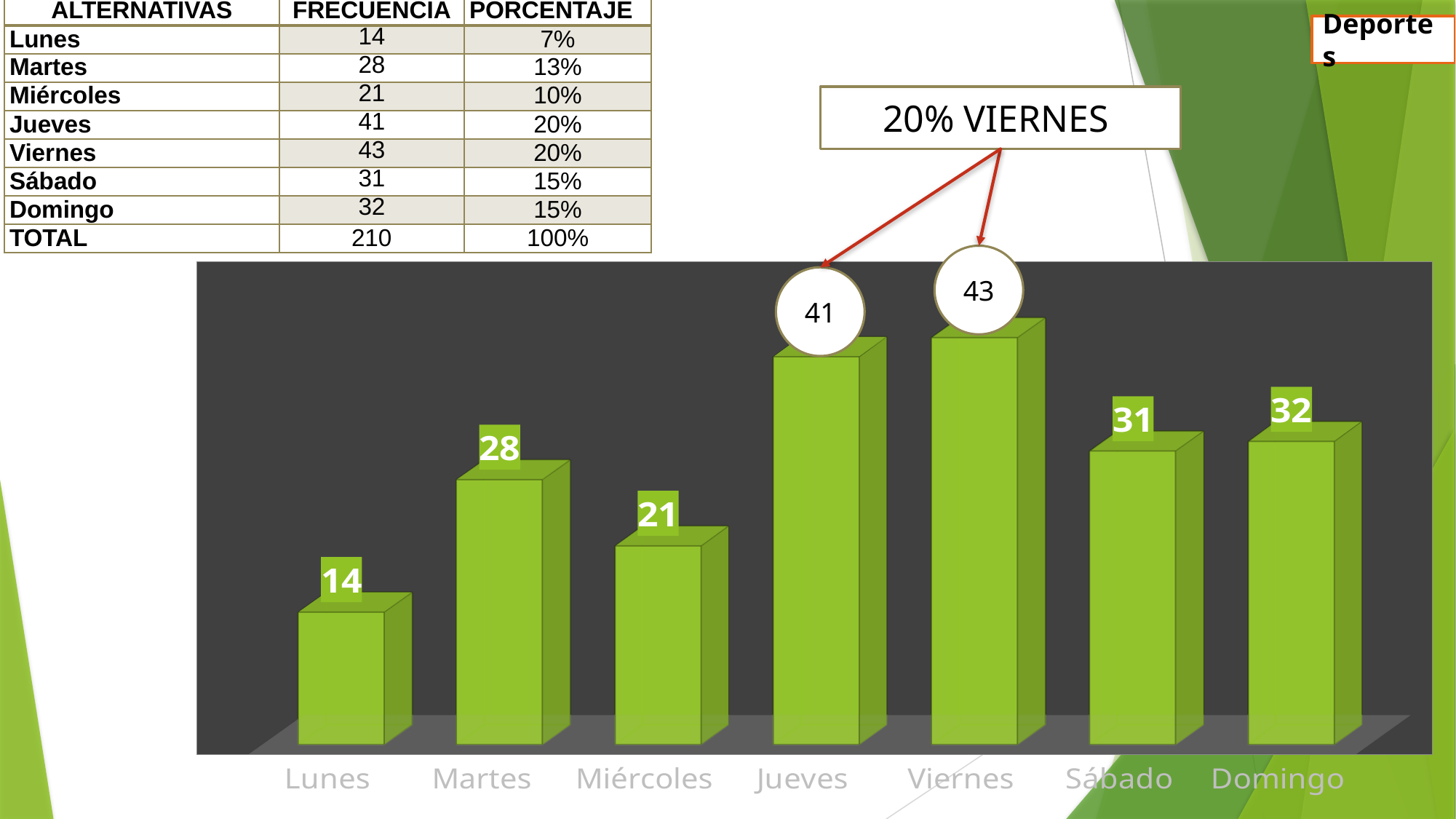
What is the value of the bar for Martes? 28 How many bars are shown in the chart? 7 What is the value of the bar for Lunes? 14 What kind of chart is shown on the slide? Bar chart What is the value of the bar for Sábado? 31 Which is larger, the value for Sábado or the value for Domingo? Domingo What is the difference between the values for Domingo and Lunes? 18 What percentage does the callout box above the chart attribute to Viernes? 20% Which day has the lowest bar? Lunes Which day has the highest bar? Viernes What is the difference between the values for Jueves and Miércoles? 20 Which is larger, the value for Martes or the value for Miércoles? Martes